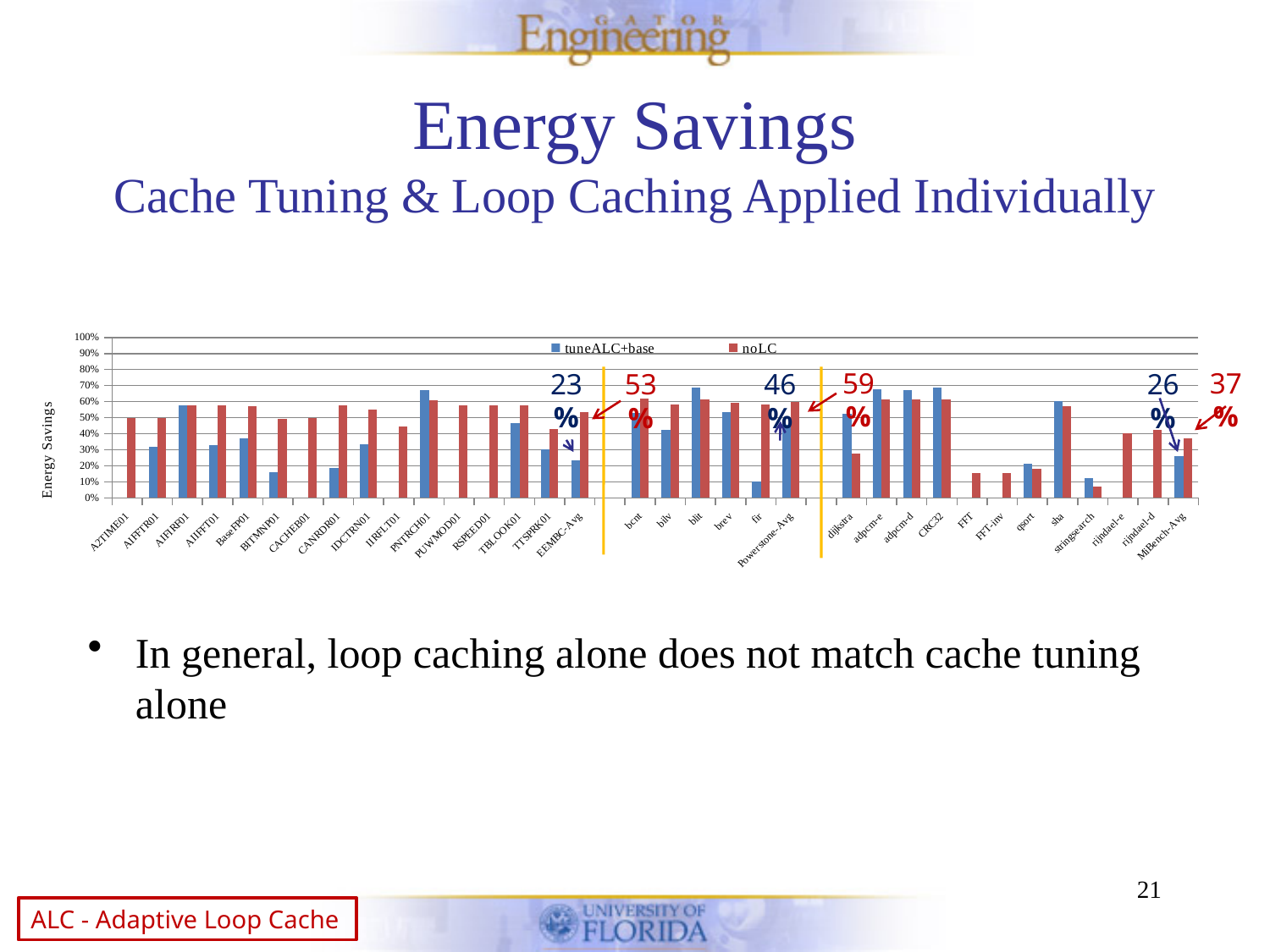
How many series does the chart legend list? 2 What is the annotated noLC value for EEMBC-Avg? 53% What are the two series named in the chart legend? tuneALC+base and noLC What is the label on the vertical axis of the chart? Energy Savings What is the annotated tuneALC+base value for EEMBC-Avg? 23% Is the noLC value for FFT greater or less than 20%? less What is the annotated noLC value for Powerstone-Avg? 59% What is the annotated noLC value for MiBench-Avg? 37% What kind of chart is shown on the slide? bar chart Is the tuneALC+base value for PNTRCH01 greater or less than 60%? greater By how many percentage points does the annotated noLC value for EEMBC-Avg exceed the annotated tuneALC+base value for EEMBC-Avg? 30 What is the annotated tuneALC+base value for MiBench-Avg? 26%